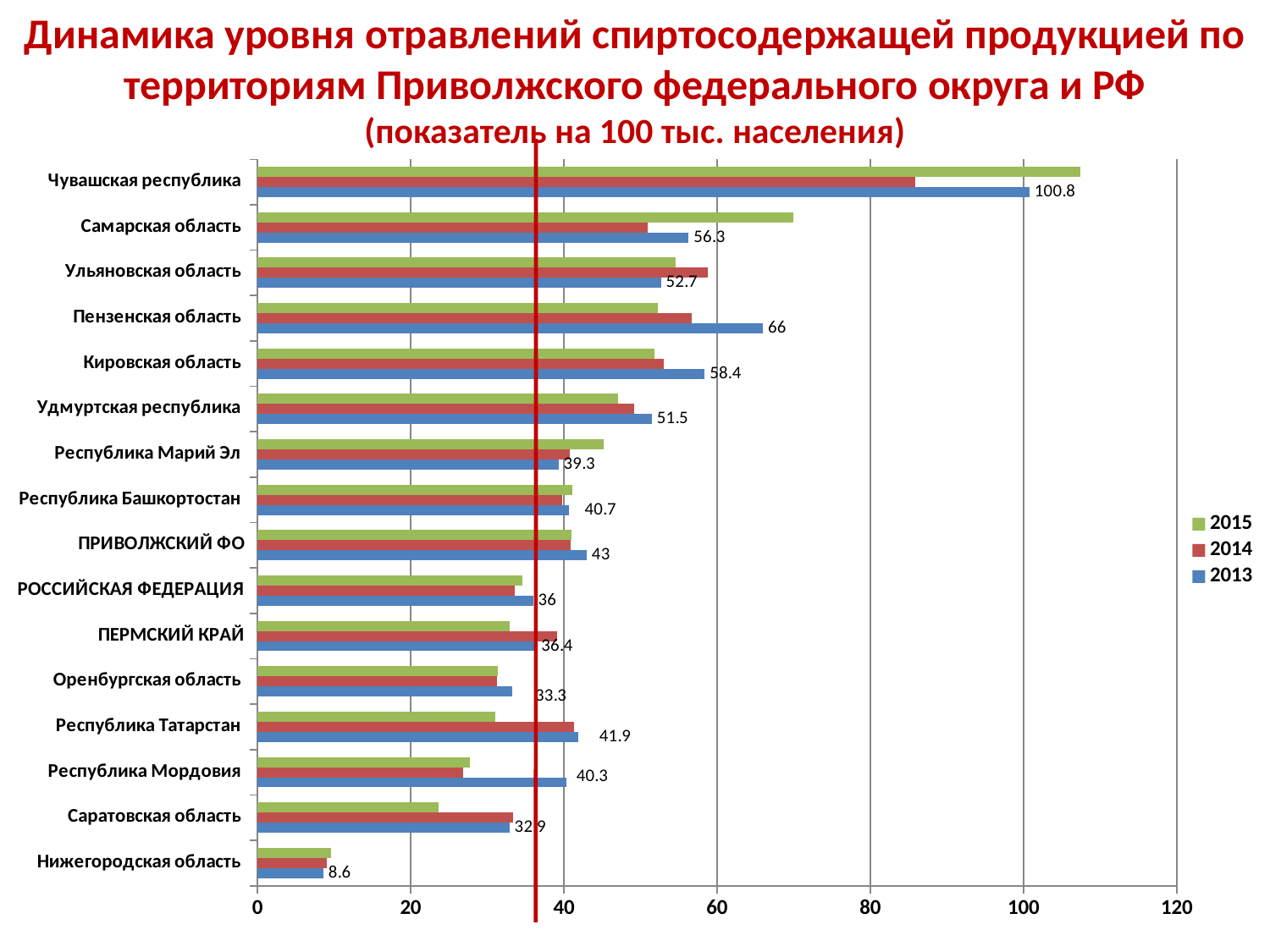
What kind of chart is shown on the slide? bar chart Is the 2015 value for Чувашская республика greater or less than 100? greater Which has the larger 2013 value, Пензенская область or Кировская область? Пензенская область How many series does the legend list? 3 What is the 2013 value for Пензенская область? 66 Which years are listed in the legend? 2015, 2014, 2013 How many territories (categories) are shown on the chart? 16 What is the 2013 value for РОССИЙСКАЯ ФЕДЕРАЦИЯ? 36 Which territory has the highest 2013 value? Чувашская республика What is the difference between the 2013 values for Чувашская республика and Нижегородская область? 92.2 Which territory has the lowest 2013 value? Нижегородская область What is the 2013 value for Чувашская республика? 100.8